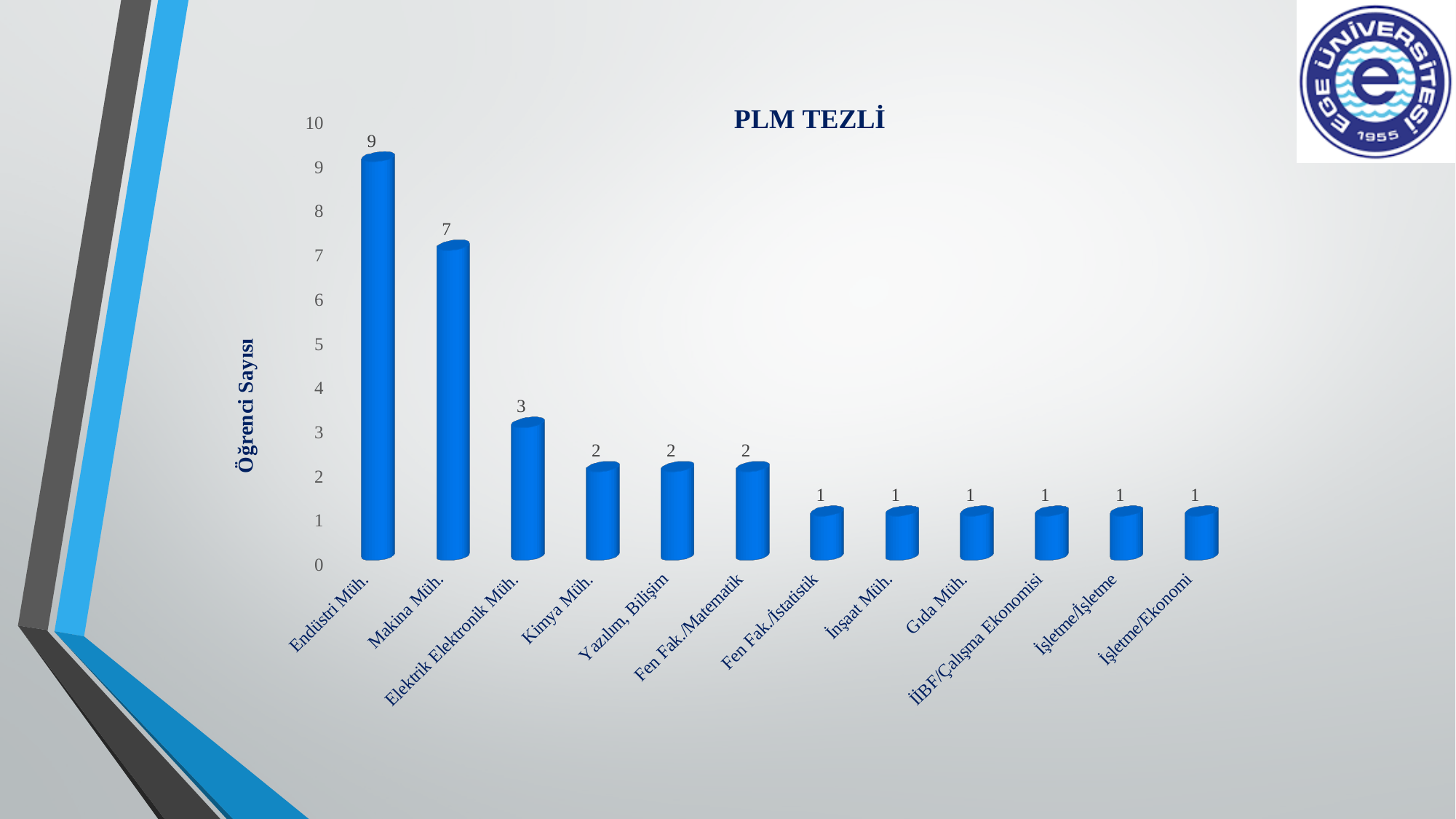
What is the value for Makina Müh.? 7 Is the value for Makina Müh. greater or less than 5? greater What kind of chart is shown on the slide? bar chart What is the value for Endüstri Müh.? 9 What is the value for Yazılım, Bilişim? 2 What is the value for Elektrik Elektronik Müh.? 3 Which is larger, the value for Elektrik Elektronik Müh. or the value for Kimya Müh.? Elektrik Elektronik Müh. How many categories are shown on the x axis? 12 What is the difference between the values for Endüstri Müh. and Makina Müh.? 2 Do the values rise or fall from left to right along the x axis? fall Which category has the highest value? Endüstri Müh. What is the title of the chart? PLM TEZLİ